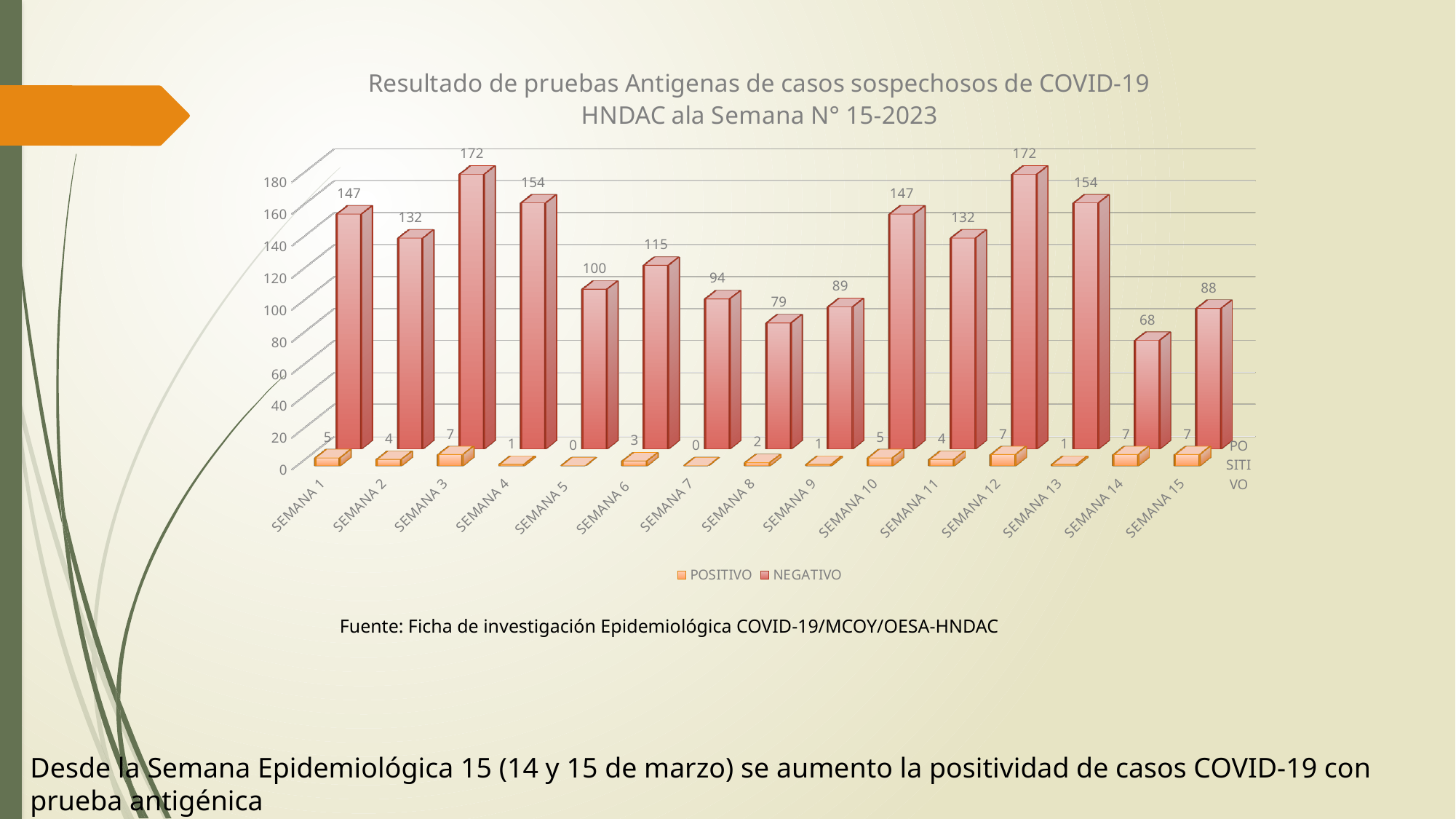
Which week has the lowest NEGATIVO value? SEMANA 14 Which is larger, the NEGATIVO value for SEMANA 6 or for SEMANA 9? SEMANA 6 Is the NEGATIVO value for SEMANA 15 greater or less than 100? less How many weeks (categories) are shown on the x axis? 15 What is the NEGATIVO value for SEMANA 8? 79 What is the total of POSITIVO and NEGATIVO for SEMANA 13? 155 What is the NEGATIVO value for SEMANA 1? 147 What kind of chart is shown on the slide? bar chart What is the POSITIVO value for SEMANA 14? 7 What is the difference between the NEGATIVO values for SEMANA 3 and SEMANA 5? 72 What is the highest NEGATIVO value shown on the chart? 172 How many series does the legend list? 2